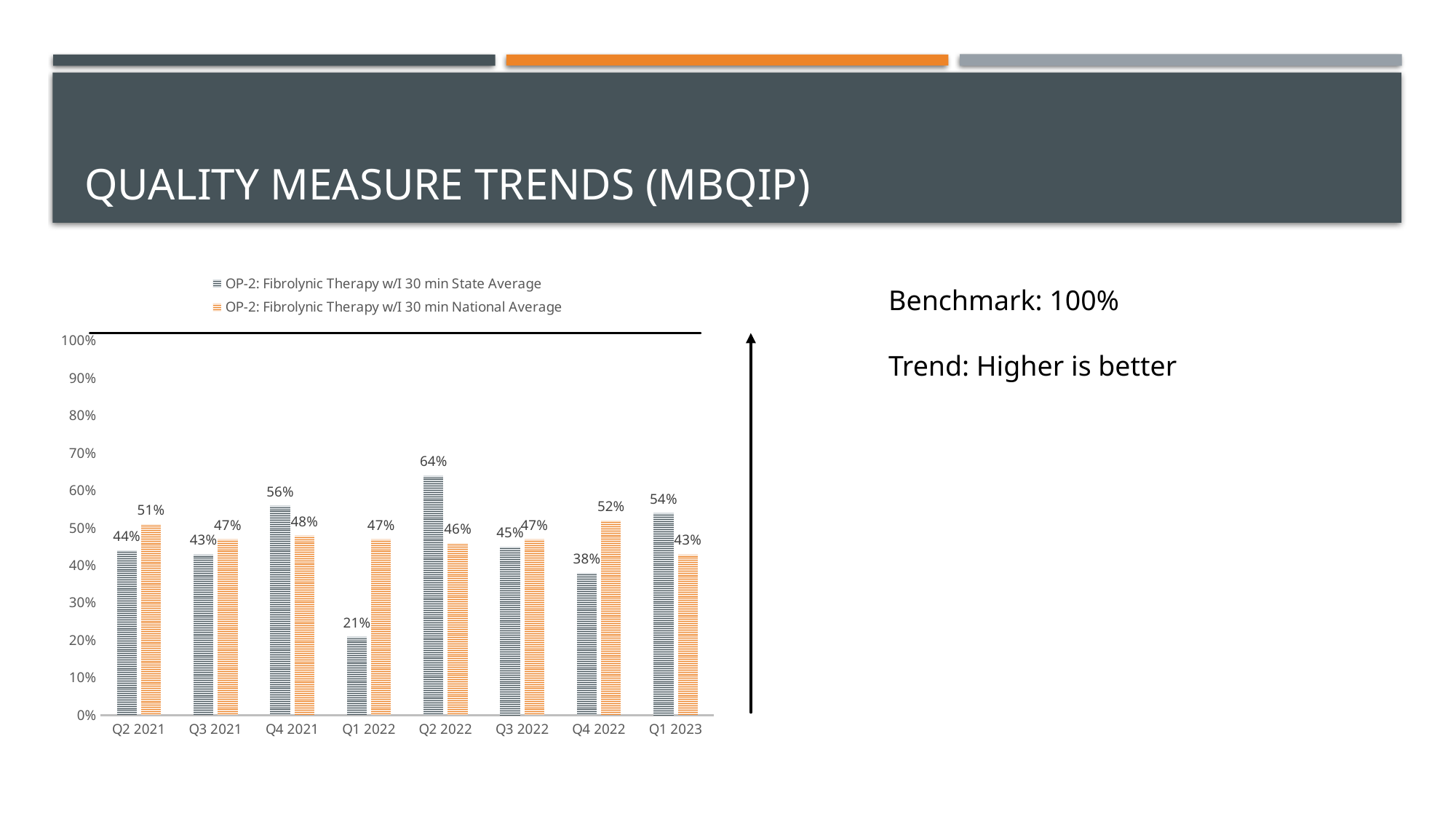
How many quarters are shown on the x axis? 8 In Q4 2021, which is larger: the State Average or the National Average? State Average What is the OP-2 National Average value for Q4 2022? 52% What is the difference between the National Average and the State Average in Q1 2022? 26% Which quarter has the lowest State Average value? Q1 2022 How many series does the legend list? 2 What kind of chart is shown on the slide? Bar chart What is the OP-2 State Average value for Q2 2022? 64% Which quarter has the lowest National Average value? Q1 2023 What is the State Average value for Q1 2022? 21% What benchmark value is stated on the slide? 100% Which quarter has the highest State Average value? Q2 2022